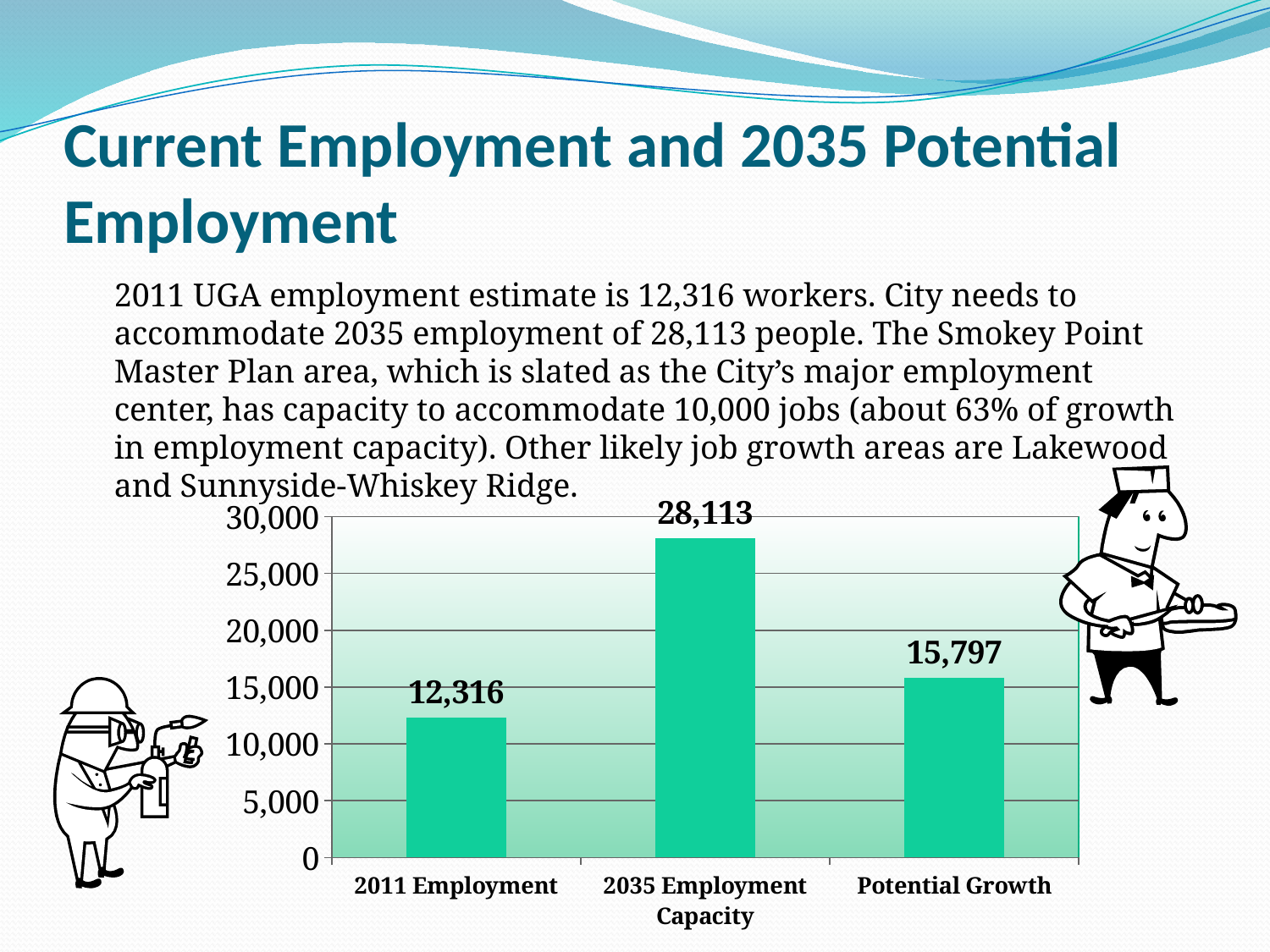
What kind of chart is shown on the slide? bar chart What is the value for 2011 Employment? 12,316 Which category has the lowest value? 2011 Employment Is the value for Potential Growth greater or less than 15,000? greater Which category has the highest value? 2035 Employment Capacity What is the highest value shown on the y axis? 30,000 What is the value for Potential Growth? 15,797 What is the difference between 2035 Employment Capacity and 2011 Employment? 15,797 Which is larger, Potential Growth or 2011 Employment? Potential Growth What is the difference between Potential Growth and 2011 Employment? 3,481 How many categories are shown on the x axis? 3 What is the value for 2035 Employment Capacity? 28,113